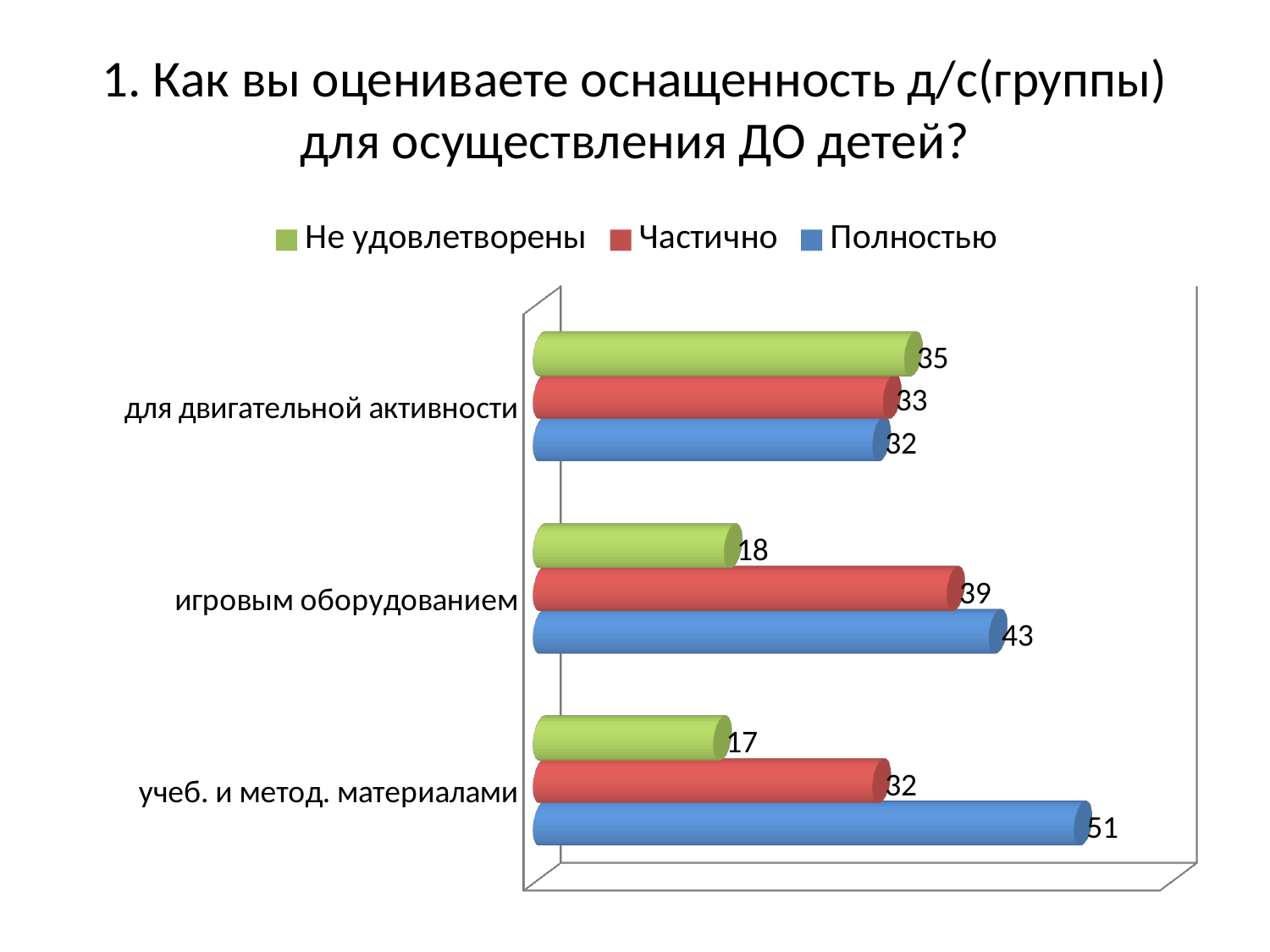
Which category has the highest value for the "Полностью" series? учеб. и метод. материалами What is the value for "Частично" in the "для двигательной активности" category? 33 How many categories are shown on the chart? 3 How many series does the legend list? 3 Which category has the lowest value for the "Не удовлетворены" series? учеб. и метод. материалами What is the difference between the "Полностью" and "Не удовлетворены" values in the "учеб. и метод. материалами" category? 34 What kind of chart is shown on the slide? bar chart What is the value for "Не удовлетворены" in the "игровым оборудованием" category? 18 What is the difference between the "Частично" values for "игровым оборудованием" and "учеб. и метод. материалами"? 7 Which series is shown in blue? Полностью Which is larger: the "Полностью" value for "игровым оборудованием" or the "Полностью" value for "для двигательной активности"? игровым оборудованием What is the value for "Полностью" in the "учеб. и метод. материалами" category? 51